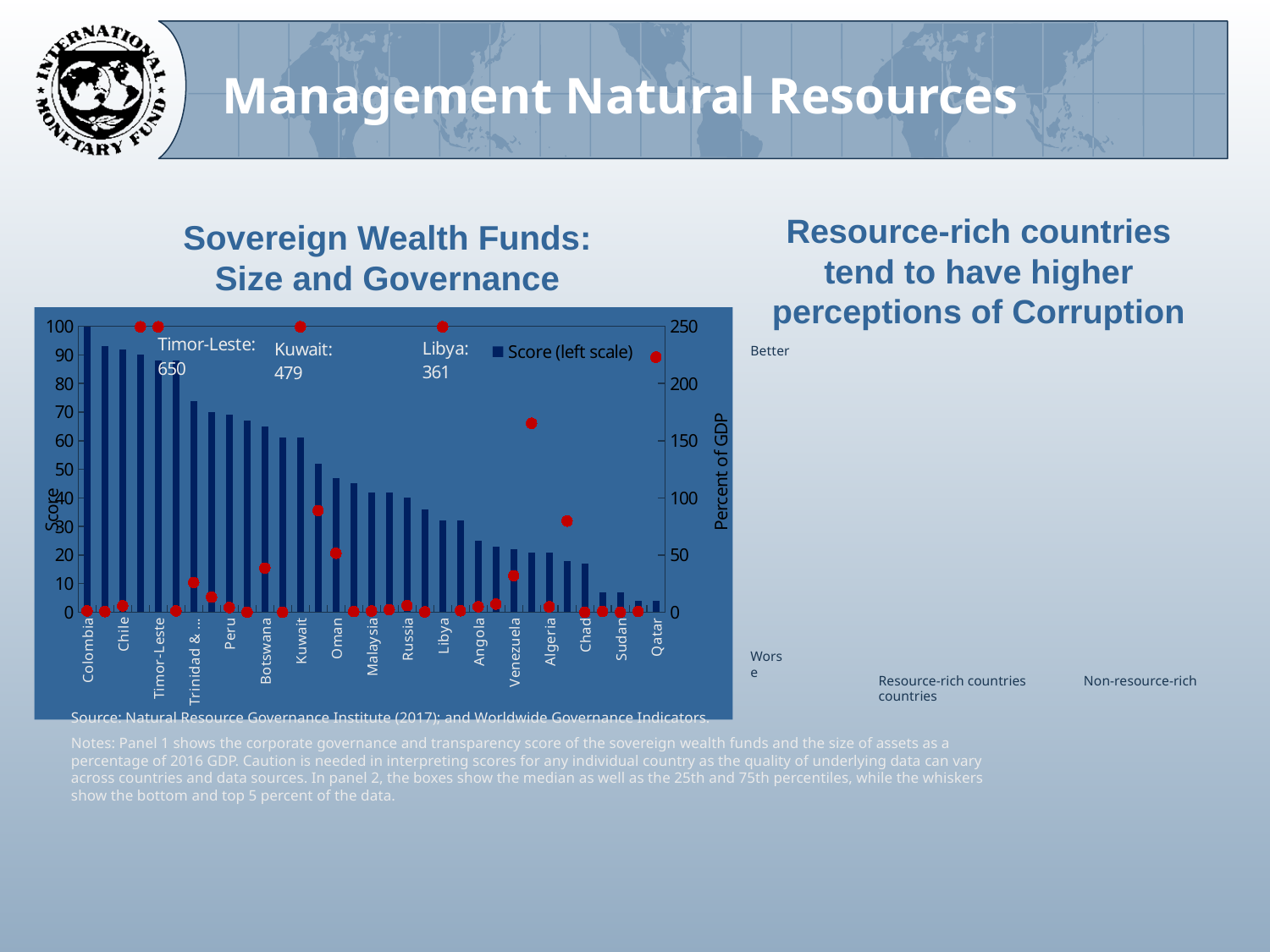
In the 'Sovereign Wealth Funds: Size and Governance' chart, what is the percent of GDP value printed for Libya? 361 In the 'Sovereign Wealth Funds: Size and Governance' chart, is the score for Botswana greater or less than 60? greater In the 'Sovereign Wealth Funds: Size and Governance' chart, which country has the highest score? Colombia In the 'Sovereign Wealth Funds: Size and Governance' chart, what is the percent of GDP value printed for Timor-Leste? 650 In the 'Sovereign Wealth Funds: Size and Governance' chart, what is the percent of GDP value printed for Kuwait? 479 In the 'Sovereign Wealth Funds: Size and Governance' chart, what is the difference between the percent of GDP values printed for Timor-Leste and Kuwait? 171 In the 'Sovereign Wealth Funds: Size and Governance' chart, do the scores generally rise or fall from left to right along the x axis? fall In the 'Sovereign Wealth Funds: Size and Governance' chart, is the score for Oman greater or less than 50? less In the 'Sovereign Wealth Funds: Size and Governance' chart, what is the difference between the percent of GDP values printed for Kuwait and Libya? 118 In the 'Sovereign Wealth Funds: Size and Governance' chart, which has a higher score, Botswana or Oman? Botswana In the 'Sovereign Wealth Funds: Size and Governance' chart, which has a larger percent of GDP value, Kuwait or Libya? Kuwait In the 'Sovereign Wealth Funds: Size and Governance' chart, which country has the highest sovereign wealth fund size as a percent of GDP? Timor-Leste